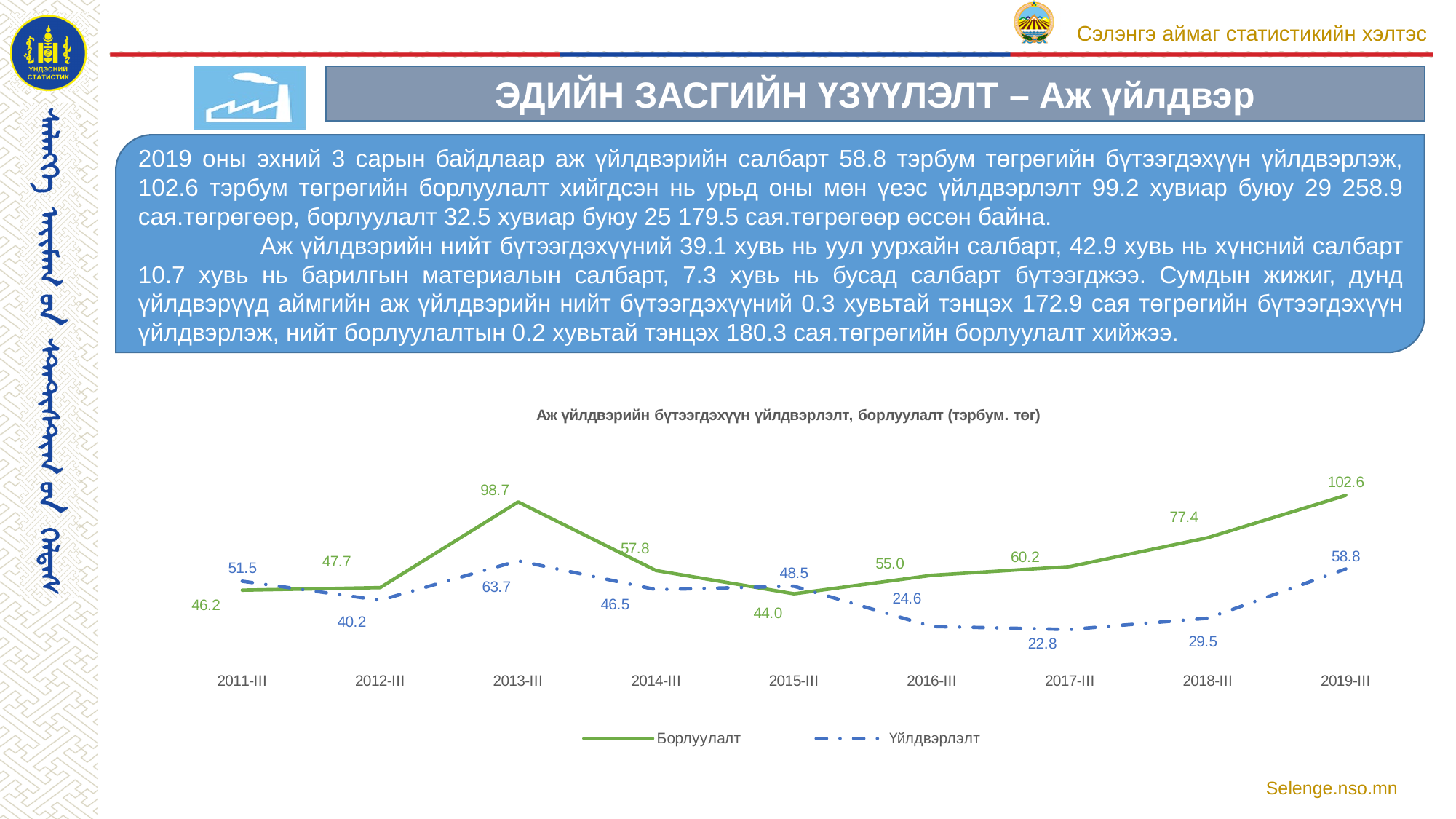
What is the difference between Борлуулалт and Үйлдвэрлэлт in 2019-III? 43.8 What is the value of Үйлдвэрлэлт for 2019-III? 58.8 In which year is Үйлдвэрлэлт lowest? 2017-III What is the value of Үйлдвэрлэлт for 2017-III? 22.8 What is the value of Борлуулалт for 2018-III? 77.4 Does Борлуулалт rise or fall from 2015-III to 2019-III? Rise What is the value of Борлуулалт for 2013-III? 98.7 What kind of chart is shown? Line chart How many series does the legend list? 2 In which year is Борлуулалт highest? 2019-III How many time points are plotted on the x axis? 9 Which is larger in 2011-III, Борлуулалт or Үйлдвэрлэлт? Үйлдвэрлэлт